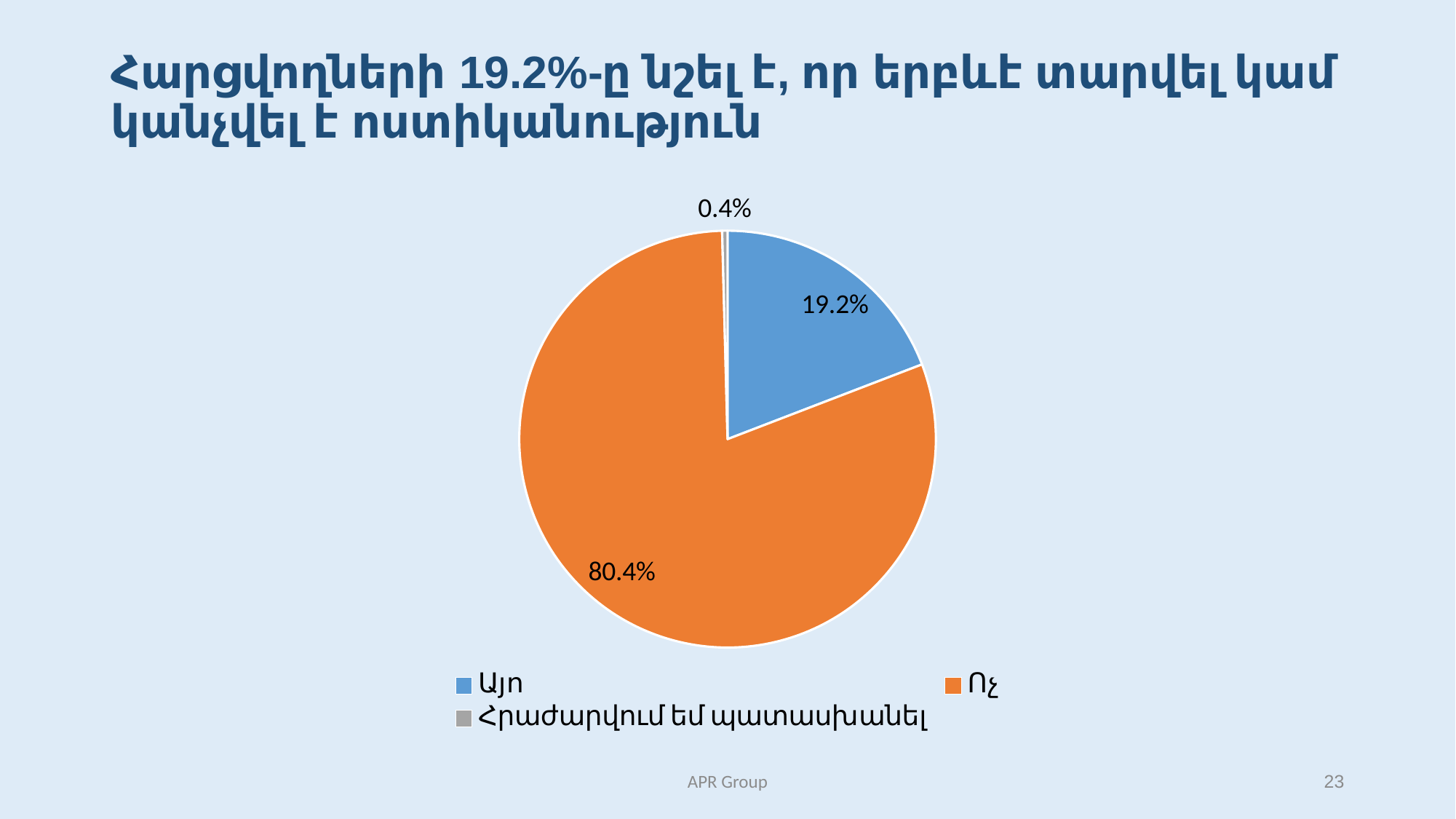
Which category has the smallest slice? Հրաժարվում եմ պատասխանել What kind of chart is shown on the slide? pie chart What is the value for Հրաժարվում եմ պատասխանել? 0.4% What colour is the slice for Ոչ? orange How many slices does the pie chart have? 3 What is the difference between the values for Ոչ and Այո? 61.2% How many entries does the legend list? 3 Which category has the largest slice? Ոչ What is the value for Այո? 19.2% What is the value for Ոչ? 80.4% What colour is the slice for Այո? blue Which is larger, the value for Այո or the value for Ոչ? Ոչ